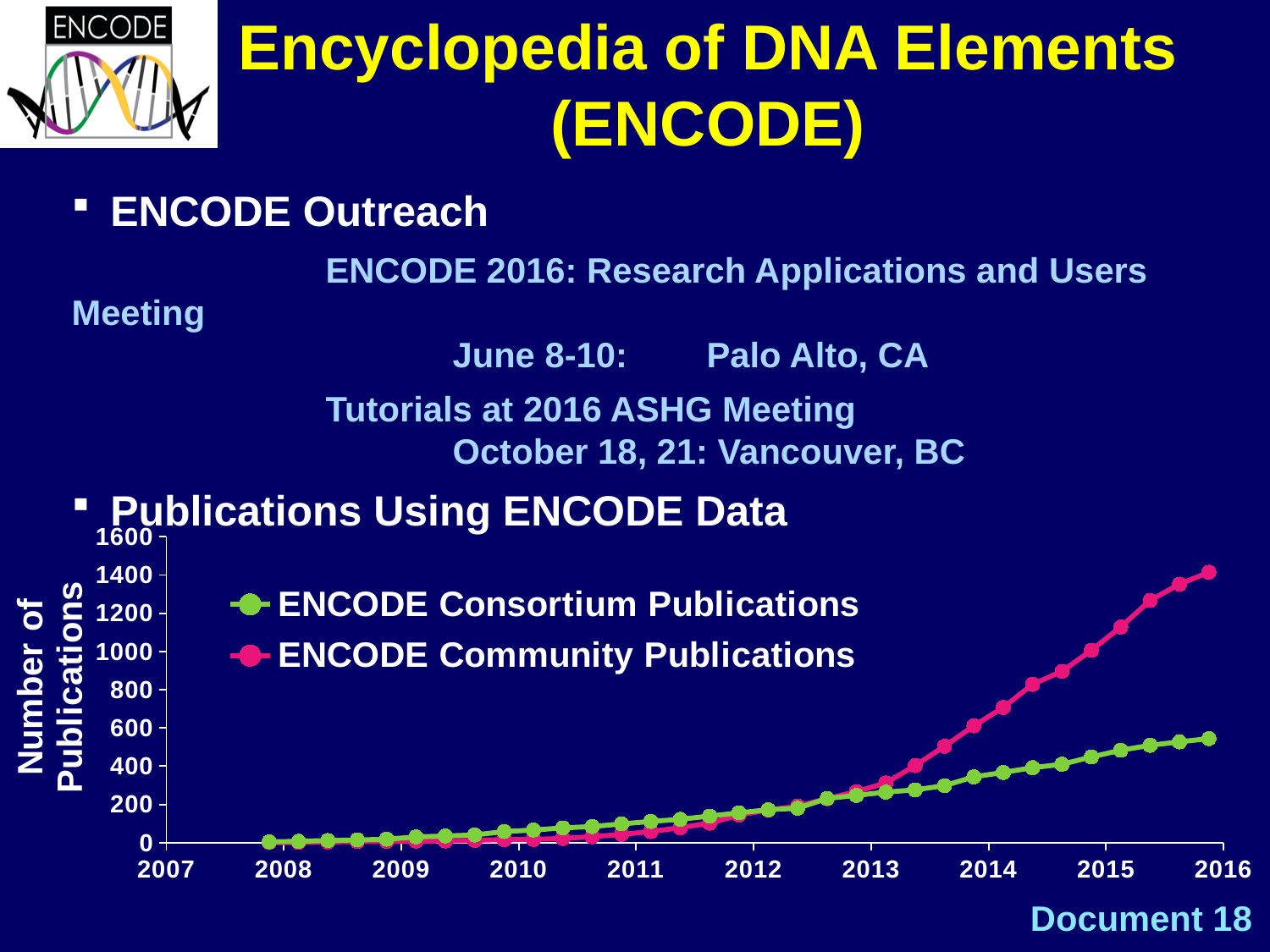
How many series does the legend of the publications chart list? 2 Do the ENCODE Community Publications values rise or fall from 2008 to 2016? rise What kind of chart is shown under "Publications Using ENCODE Data"? line chart How many year labels are shown on the horizontal axis of the publications chart? 10 Around 2011, which series has the larger value: ENCODE Consortium Publications or ENCODE Community Publications? ENCODE Consortium Publications Which series is drawn in green in the publications chart? ENCODE Consortium Publications Is the value for ENCODE Community Publications at the end of the series (near 2016) greater or less than 1200? greater Do the ENCODE Consortium Publications values rise or fall over the years shown? rise Is the value for ENCODE Consortium Publications at the end of the series (near 2016) greater or less than 600? less Is the value for ENCODE Consortium Publications at the end of the series (near 2016) greater or less than 400? greater What is the label on the vertical axis of the publications chart? Number of Publications Near 2016, which series has the larger value: ENCODE Consortium Publications or ENCODE Community Publications? ENCODE Community Publications